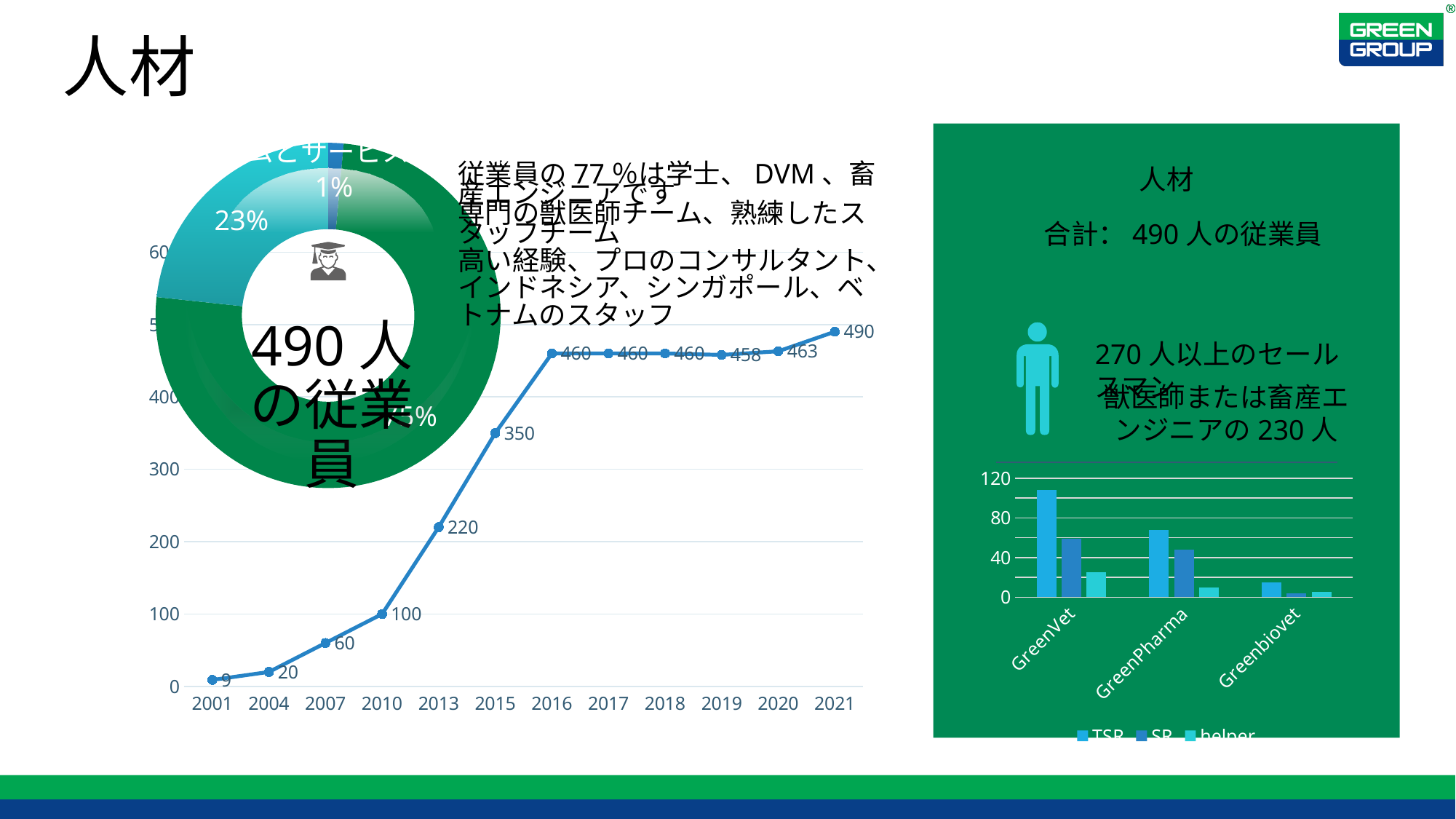
In the line chart, what is the difference between the values for 2015 and 2013? 130 How many series does the legend of the bar chart on the right list? 3 How many data points are plotted in the line chart? 12 In the bar chart on the right, which category has the highest TSR value? GreenVet In the line chart, do the values generally rise or fall from 2001 to 2021? rise In the line chart, which year has the lowest value? 2001 In the line chart, what is the value for 2021? 490 What kind of chart is the chart at the bottom left of the slide? line chart In the bar chart on the right, is the TSR value for GreenVet greater or less than 80? greater In the line chart, which year has the highest value? 2021 In the line chart, what is the value for 2013? 220 In the line chart, what is the difference between the values for 2021 and 2020? 27